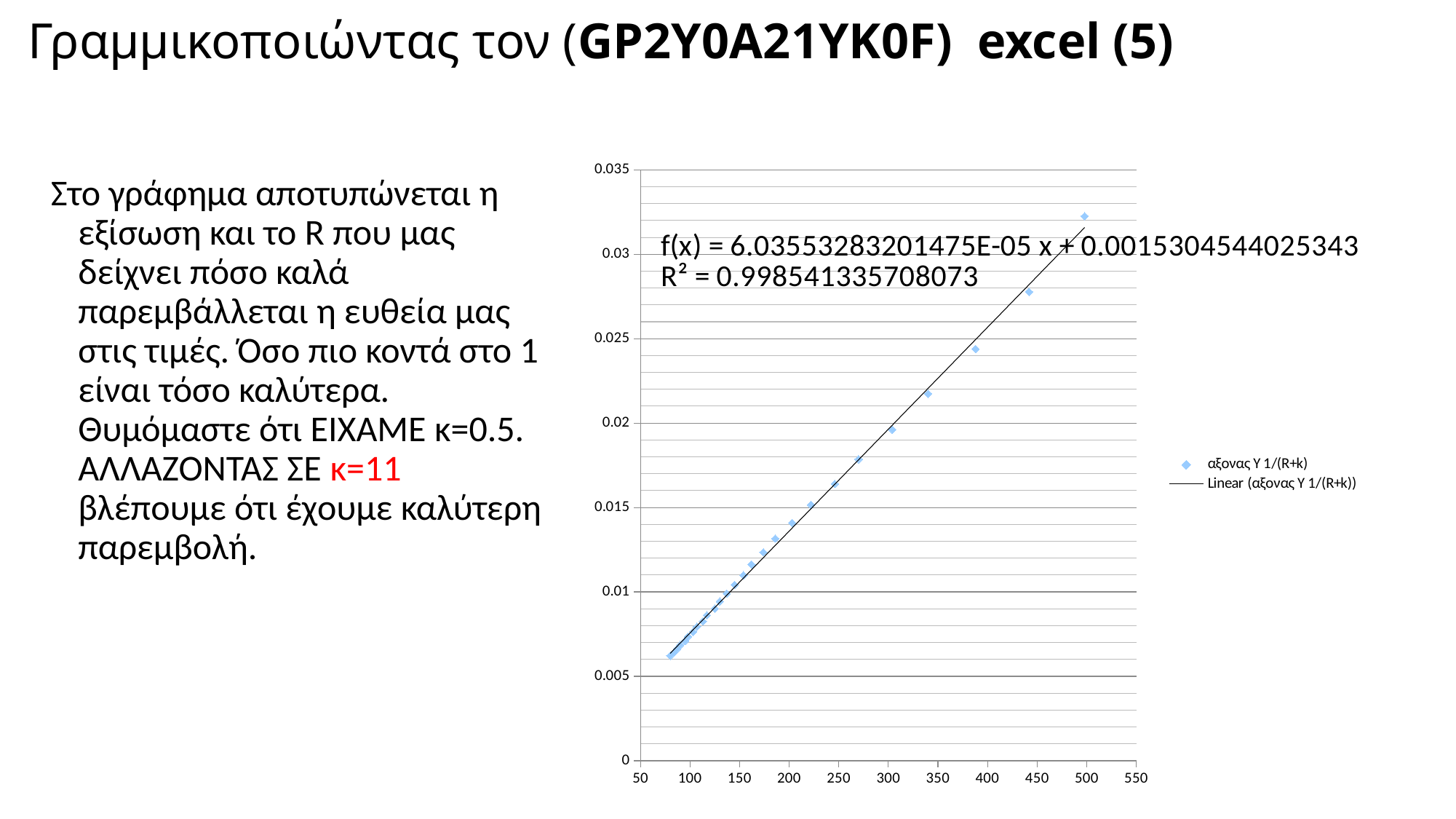
What R² value is printed on the chart? R² = 0.998541335708073 What kind of chart is shown on the slide? scatter chart How many series does the chart legend list? 2 What is the equation of the trendline printed on the chart? f(x) = 6.03553283201475E-05 x + 0.0015304544025343 Is the value of the data point at x = 500 greater or less than 0.03? greater Is the value of the data point at x = 250 greater or less than 0.015? greater Is the value of the data point at x = 450 greater or less than 0.025? greater What is the highest value shown on the y axis? 0.035 Which of the two data points has the larger y value: the one at x = 500 or the one at x = 350? the one at x = 500 Do the plotted values rise or fall as x increases along the x axis? rise